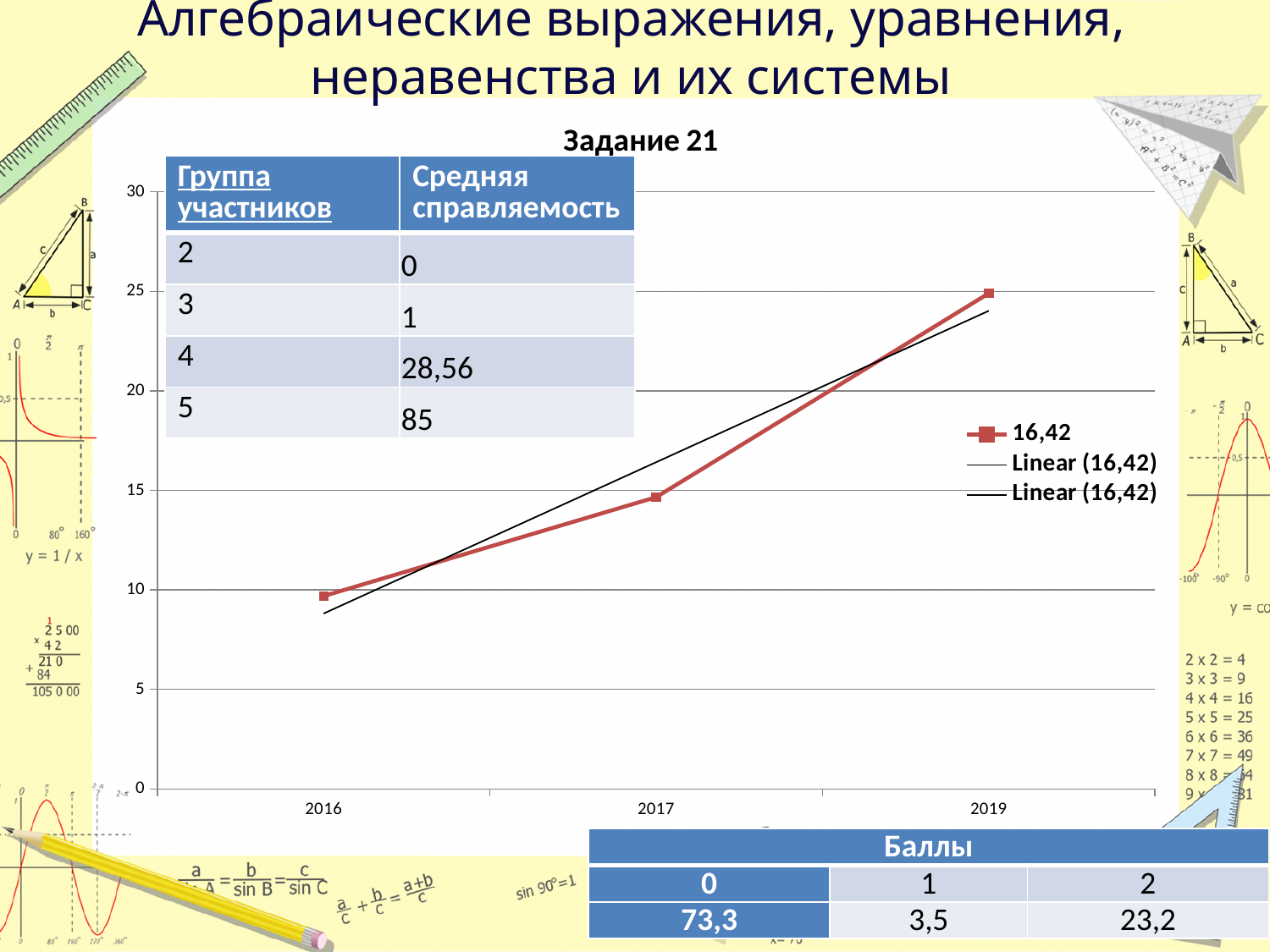
How many years are plotted on the x axis of the chart? 3 Which year has the larger value on the "16,42" line, 2016 or 2017? 2017 Which year has the lowest value on the "16,42" line? 2016 How many entries does the chart legend list? 3 Is the value for 2016 on the "16,42" line greater or less than 5? greater What is the title of the chart? Задание 21 Is the value for 2017 on the "16,42" line greater or less than 10? greater Do the values of the "16,42" line rise or fall from 2016 to 2019? rise What is the name of the series shown with red square markers in the legend? 16,42 What kind of chart is shown under the title "Задание 21"? line chart Which year has the highest value on the "16,42" line? 2019 Is the value for 2019 on the "16,42" line greater or less than 20? greater